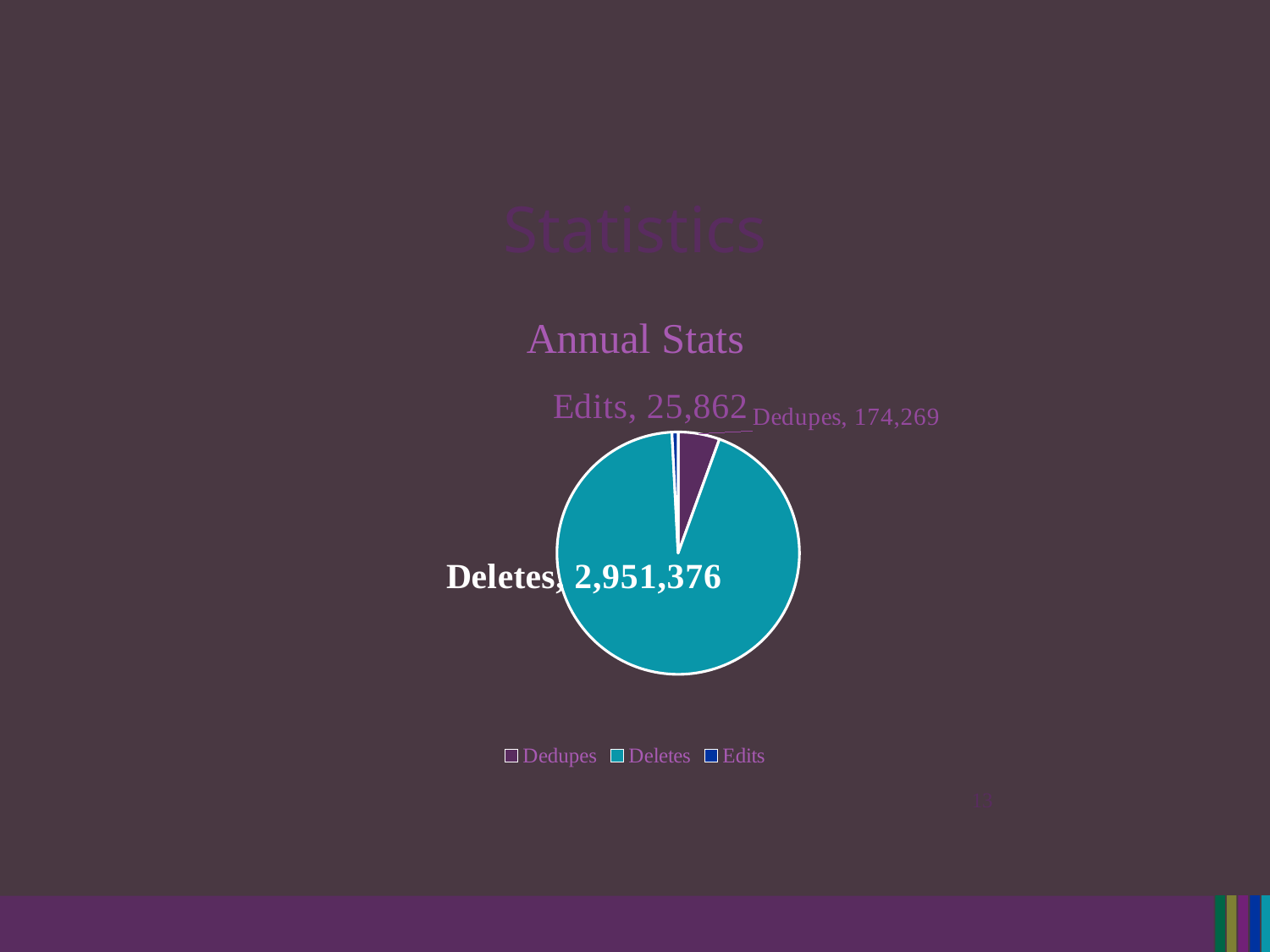
What is the total of all three slices in the pie chart? 3,151,507 How many categories does the pie chart have? 3 Which is larger, Dedupes or Edits? Dedupes What type of chart is shown on the slide? Pie chart What is the value for Dedupes? 174,269 Which category has the smallest slice of the pie? Edits What is the value for Edits? 25,862 What is the value for Deletes? 2,951,376 Which category has the largest slice of the pie? Deletes What is the difference between the Dedupes value and the Edits value? 148,407 What is the title of the chart? Annual Stats What is the difference between the Deletes value and the Dedupes value? 2,777,107